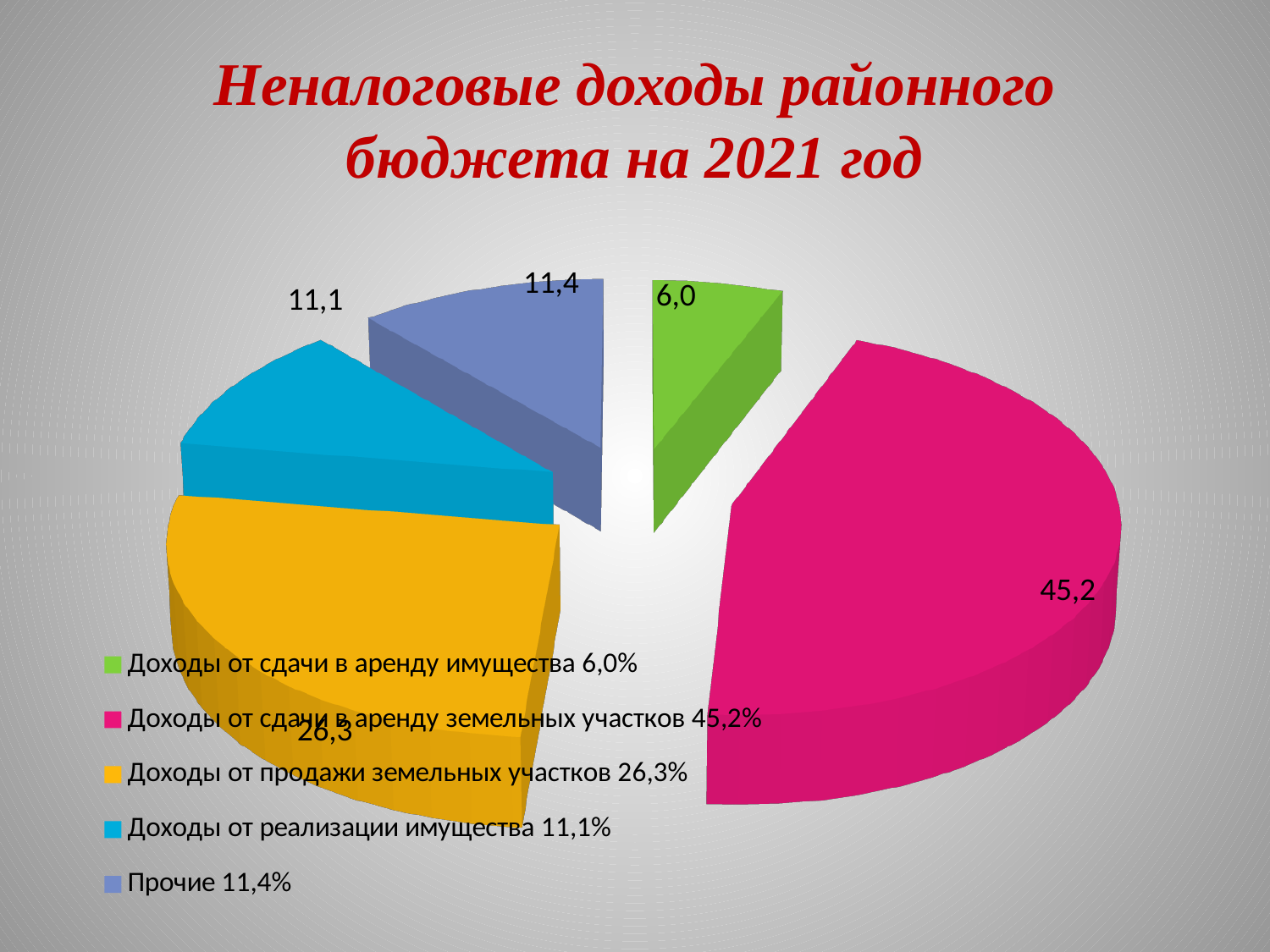
Which is larger: the slice for "Доходы от продажи земельных участков" or the slice for "Доходы от реализации имущества"? Доходы от продажи земельных участков Which category is shown in pink on the pie chart? Доходы от сдачи в аренду земельных участков How many slices does the pie chart have? 5 What value is shown for the slice "Доходы от продажи земельных участков"? 26,3 What value is shown for the slice "Доходы от реализации имущества"? 11,1 What is the difference between the values for "Доходы от сдачи в аренду земельных участков" and "Доходы от продажи земельных участков"? 18,9 What value is shown for the slice "Прочие"? 11,4 Which category has the largest slice of the pie? Доходы от сдачи в аренду земельных участков What kind of chart is shown on the slide? Pie chart What value is shown for the slice "Доходы от сдачи в аренду земельных участков"? 45,2 Which category has the smallest slice of the pie? Доходы от сдачи в аренду имущества What is the title of the chart on the slide? Неналоговые доходы районного бюджета на 2021 год